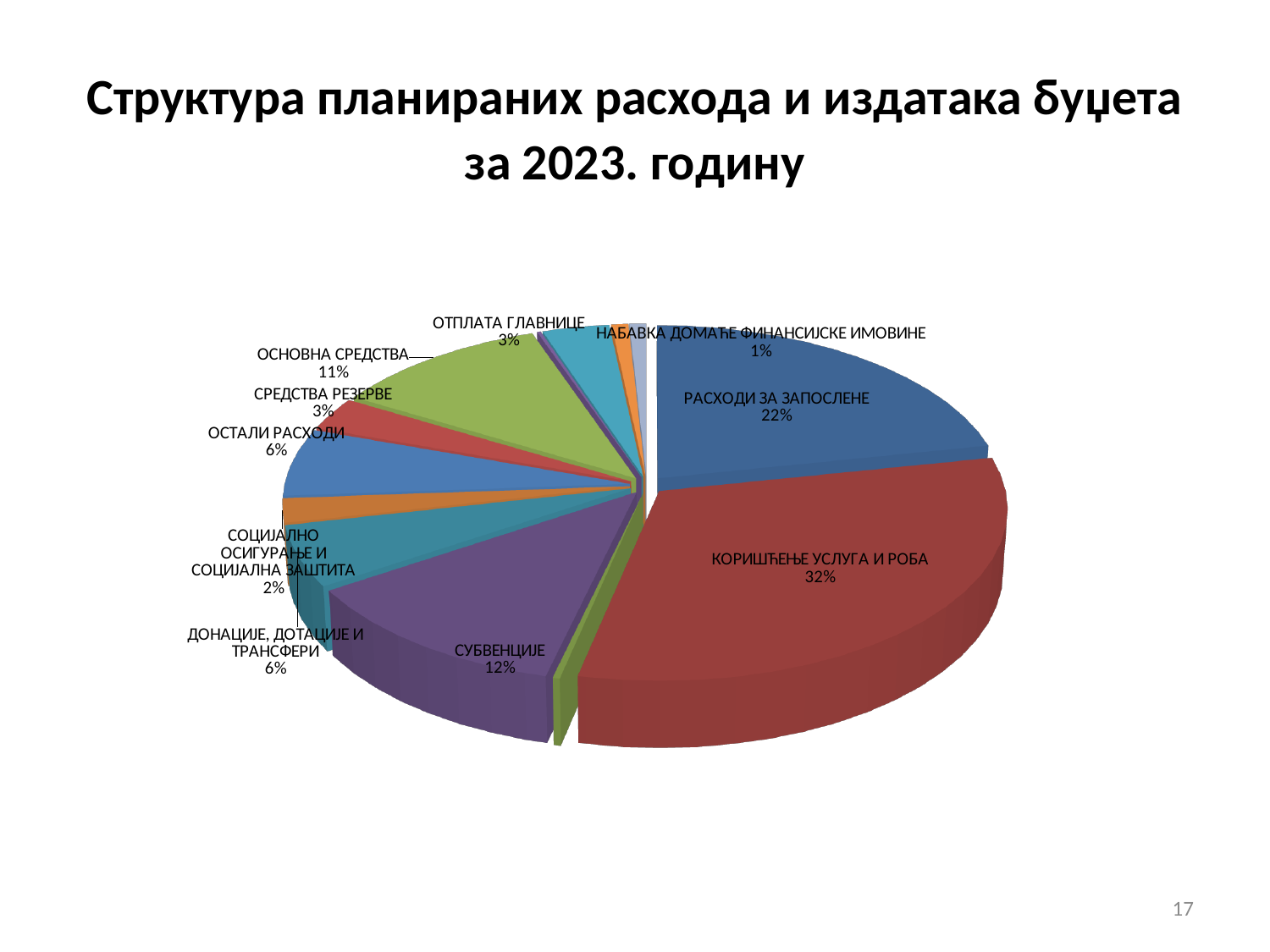
What kind of chart is shown on the slide? pie chart What is the value shown for РАСХОДИ ЗА ЗАПОСЛЕНЕ? 22% What is the difference in percentage points between КОРИШЋЕЊЕ УСЛУГА И РОБА and РАСХОДИ ЗА ЗАПОСЛЕНЕ? 10 What is the value shown for ОСНОВНА СРЕДСТВА? 11% Which category has the largest share of the pie? КОРИШЋЕЊЕ УСЛУГА И РОБА What is the value shown for СУБВЕНЦИЈЕ? 12% Which labelled category has the smallest share of the pie? НАБАВКА ДОМАЋЕ ФИНАНСИЈСКЕ ИМОВИНЕ Which is larger, СУБВЕНЦИЈЕ or ОСНОВНА СРЕДСТВА? СУБВЕНЦИЈЕ What is the value shown for СОЦИЈАЛНО ОСИГУРАЊЕ И СОЦИЈАЛНА ЗАШТИТА? 2% What share of the pie does КОРИШЋЕЊЕ УСЛУГА И РОБА represent? 32% What is the value shown for НАБАВКА ДОМАЋЕ ФИНАНСИЈСКЕ ИМОВИНЕ? 1% What is the title of the slide? Структура планираних расхода и издатака буџета за 2023. годину